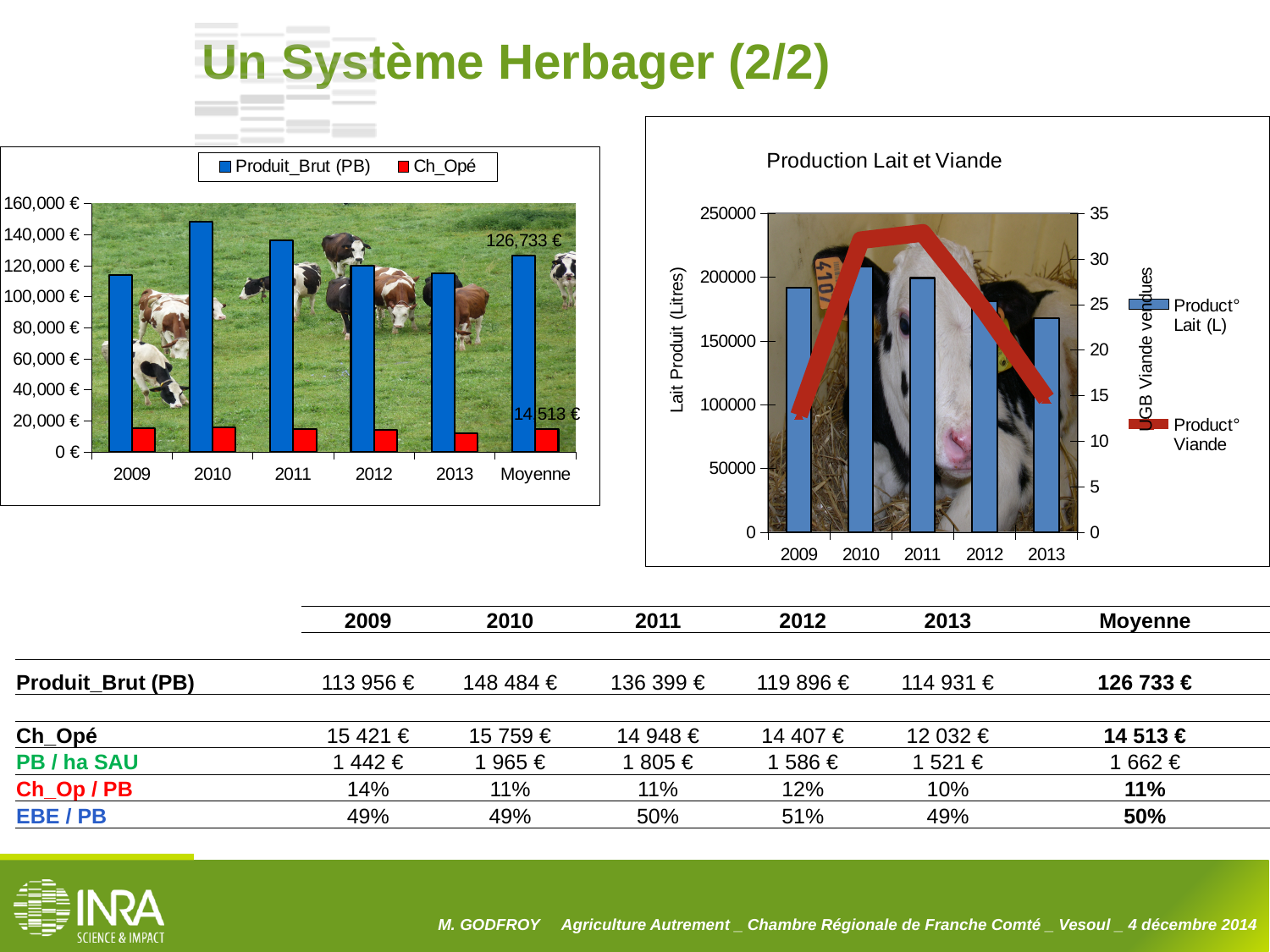
In the 'Production Lait et Viande' chart, is the Product° Viande value for 2010 greater or less than 30? greater On the left chart, is the Ch_Opé value for 2011 greater or less than 20,000 €? less On the left chart, which year has the highest Produit_Brut (PB) bar? 2010 In the 'Production Lait et Viande' chart, is the Product° Lait (L) value for 2013 greater or less than 200000? less On the left chart, what is the Ch_Opé value labelled for Moyenne? 14,513 € On the left chart, how many categories are shown on the x axis? 6 In the 'Production Lait et Viande' chart, which year has the highest Product° Lait (L) bar? 2010 In the 'Production Lait et Viande' chart, which year has the lowest Product° Lait (L) bar? 2013 On the left chart, what is the Produit_Brut (PB) value labelled for Moyenne? 126,733 € On the left chart, how many series does the legend list? 2 On the left chart, which year has the lowest Ch_Opé bar? 2013